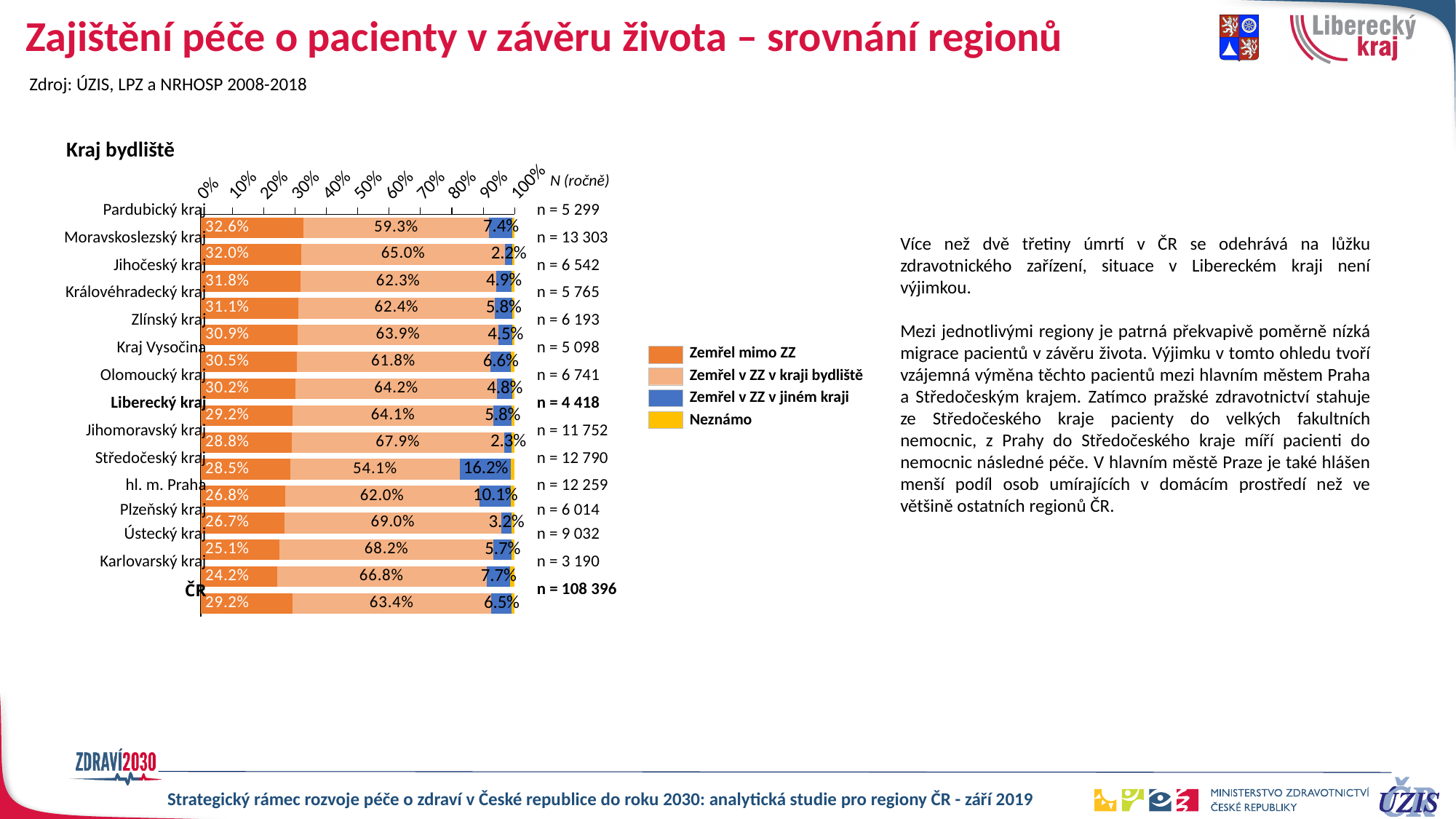
How many categories (rows) are plotted in the chart, including ČR? 15 What is the value of 'Zemřel mimo ZZ' for Liberecký kraj? 29.2% What is the value of 'Zemřel v ZZ v jiném kraji' for Středočeský kraj? 16.2% What type of chart is shown on the slide? stacked bar chart Which is larger: the 'Zemřel v ZZ v jiném kraji' value for hl. m. Praha or for Karlovarský kraj? hl. m. Praha What is the annual N shown for Liberecký kraj? n = 4 418 How many series does the legend list? 4 Which region has the highest share of 'Zemřel v ZZ v jiném kraji'? Středočeský kraj What is the value of 'Zemřel v ZZ v kraji bydliště' for Plzeňský kraj? 69.0% Which region has the highest share of 'Zemřel mimo ZZ'? Pardubický kraj Which region has the lowest share of 'Zemřel mimo ZZ'? Karlovarský kraj What is the difference between the 'Zemřel mimo ZZ' values for Pardubický kraj and Karlovarský kraj? 8.4%